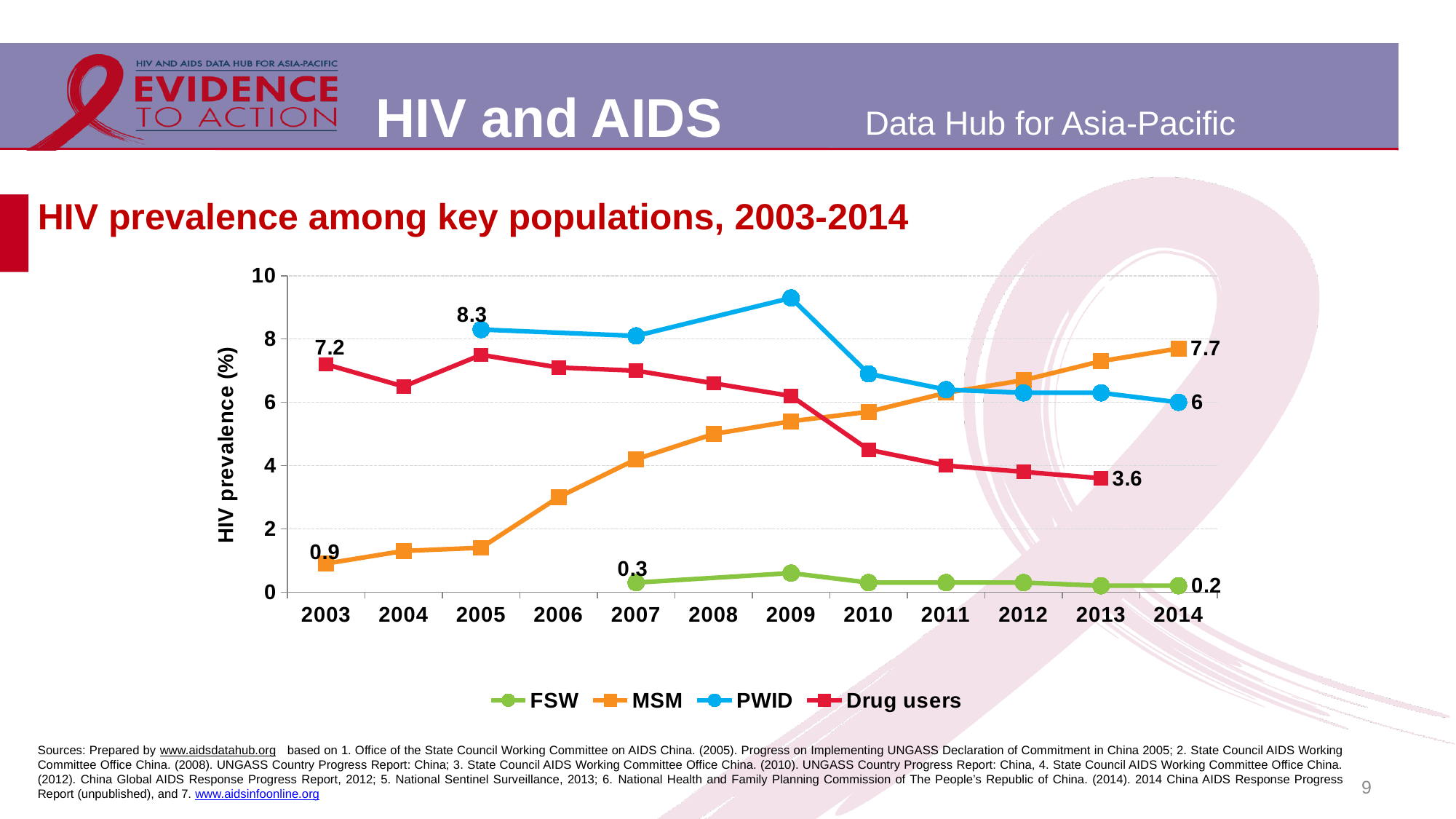
What is the difference between the MSM value in 2014 and the MSM value in 2003? 6.8 Does the MSM series rise or fall from 2003 to 2014? rise Is the PWID value in 2009 greater or less than 8? greater What is the HIV prevalence among FSW in 2014? 0.2 What is the HIV prevalence among PWID in 2005? 8.3 Which series has the highest value in 2014? MSM How many series does the legend list? 4 Which series has the lowest value in 2009? FSW What is the HIV prevalence among MSM in 2014? 7.7 What is the HIV prevalence among drug users in 2003? 7.2 What is the difference between the drug users value in 2003 and in 2013? 3.6 What type of chart is shown on the slide? line chart